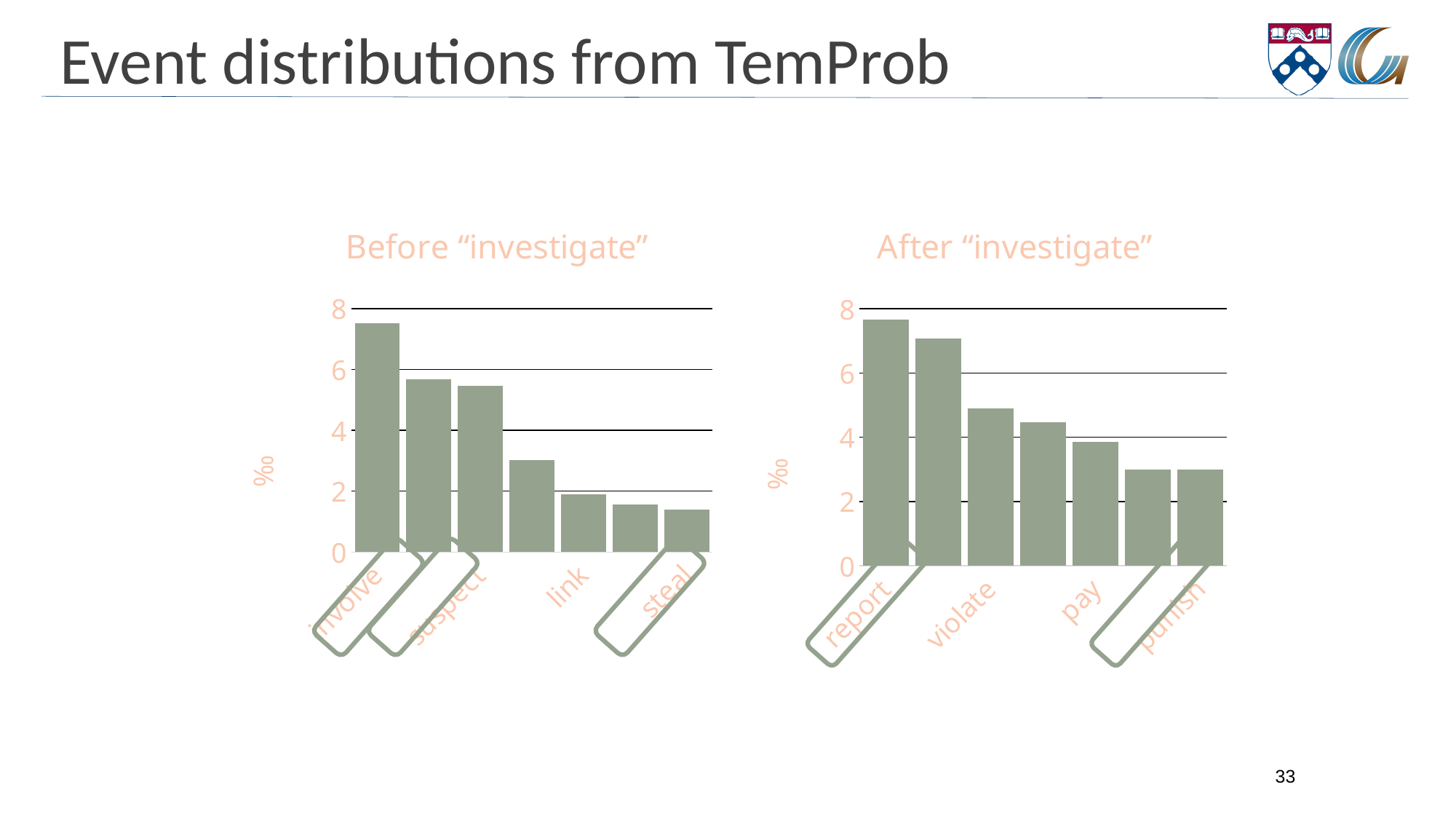
In the "After "investigate"" chart, is the value for violate greater or less than 4? greater How many bars does the "After "investigate"" chart have? 7 In the "Before "investigate"" chart, which category has the highest value? involve Do the values in the "After "investigate"" chart rise or fall from left to right? fall In the "Before "investigate"" chart, is the value for link greater or less than 4? less In the "After "investigate"" chart, is the value for punish greater or less than 4? less In the "Before "investigate"" chart, which category has the lowest value? steal In the "After "investigate"" chart, which category has the highest value? report In the "After "investigate"" chart, which is larger, report or pay? report What kind of chart is the "Before "investigate"" chart? bar chart How many bars does the "Before "investigate"" chart have? 7